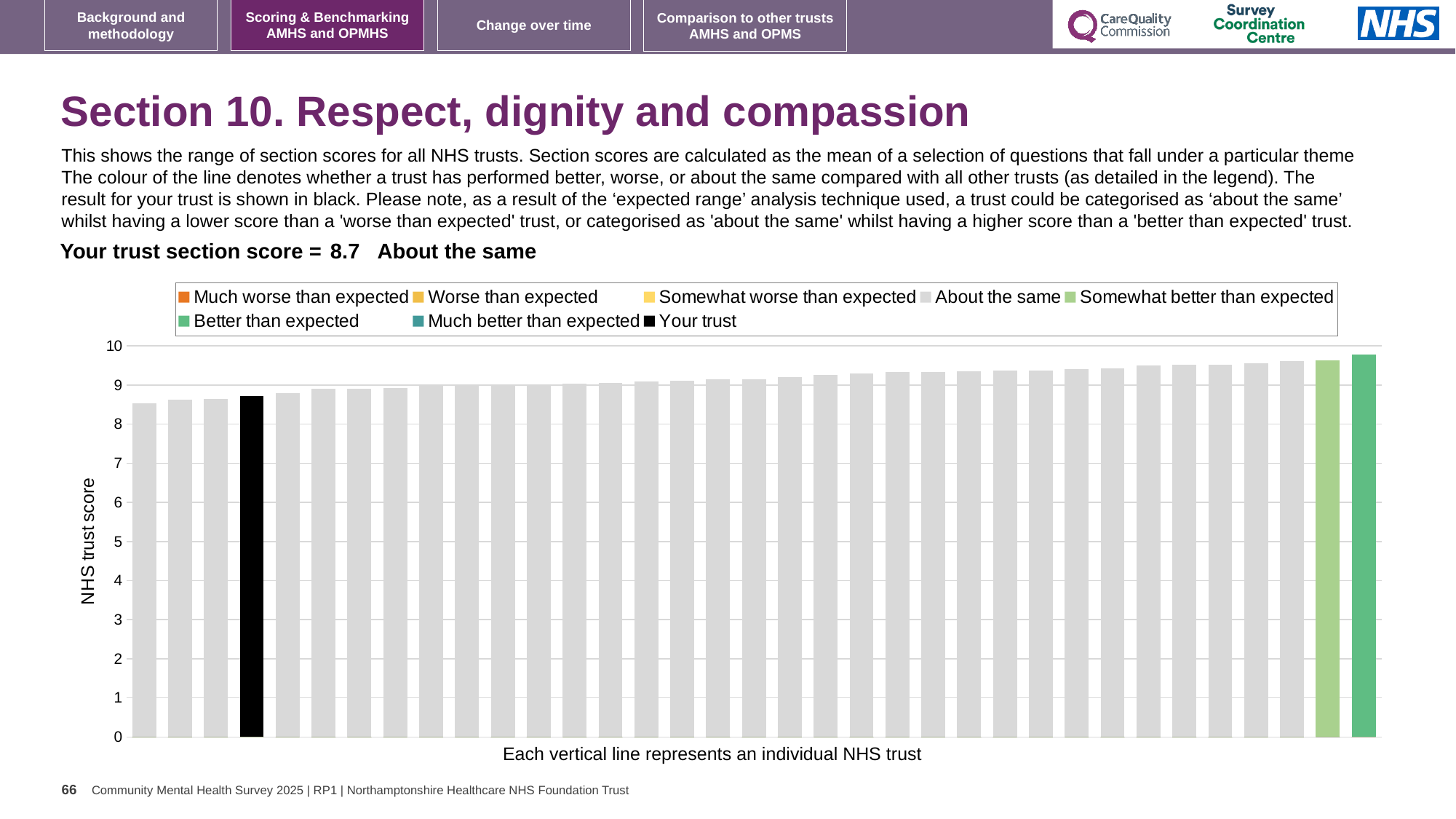
What colour is the bar representing your trust? black Is the value of the black 'Your trust' bar greater or less than 8? greater What kind of chart is shown on the slide? bar chart Which is larger, the rightmost bar or the black 'Your trust' bar? the rightmost bar Is the value of the tallest bar greater or less than 9? greater What is the section score for your trust? 8.7 Is the value of the black 'Your trust' bar greater or less than 9? less Do the bar values rise or fall from left to right along the x axis? rise What is the label on the vertical axis of the chart? NHS trust score How many entries does the chart legend list? 8 Which performance category is your trust placed in for this section? About the same